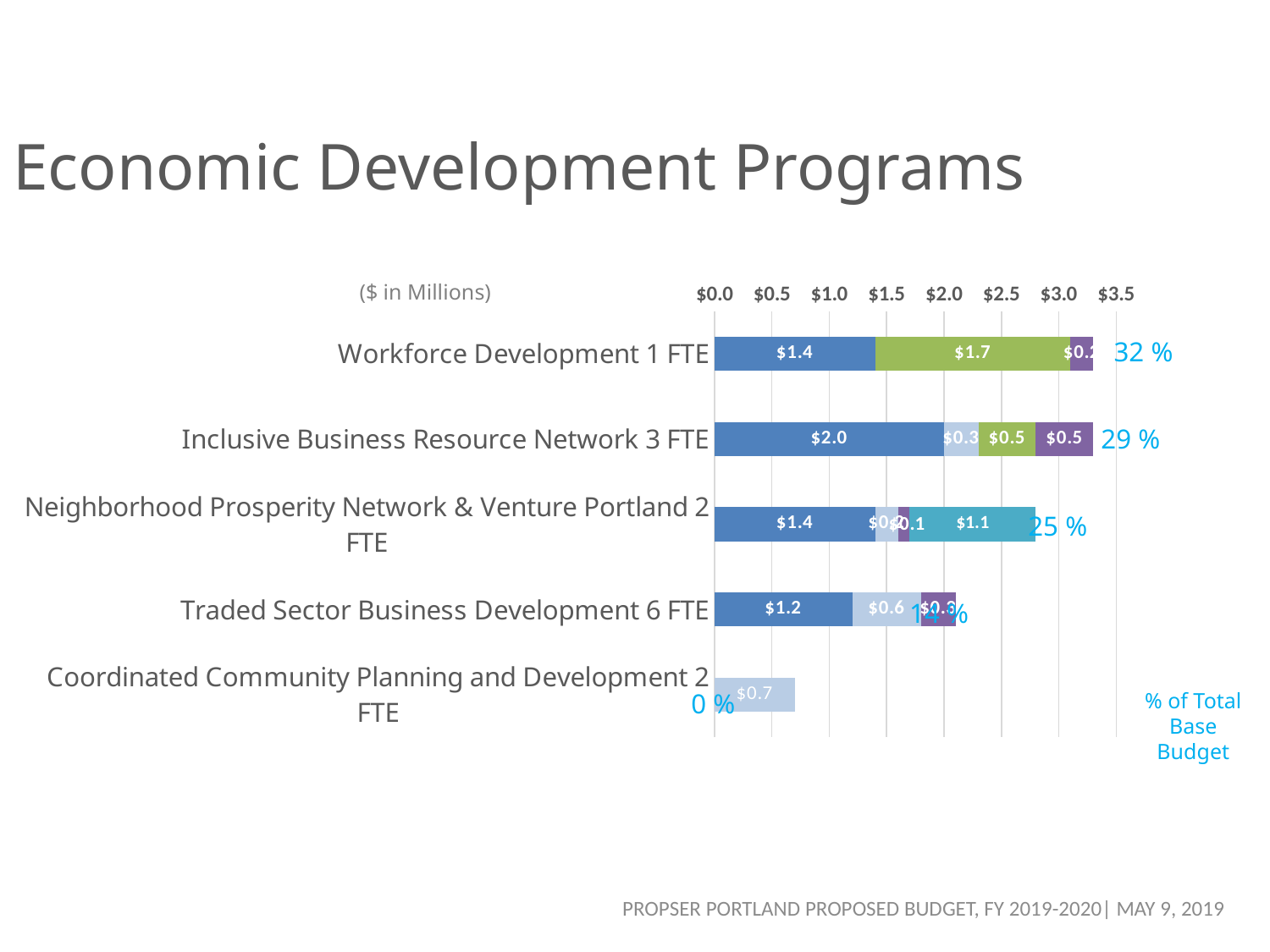
What kind of chart is shown on the slide? Stacked bar chart What is the % of Total Base Budget for Workforce Development 1 FTE? 32 % Which program has the lowest % of Total Base Budget? Coordinated Community Planning and Development 2 FTE What is the % of Total Base Budget for Inclusive Business Resource Network 3 FTE? 29 % What unit label is shown above the category axis of the chart? ($ in Millions) What is the total of the Inclusive Business Resource Network 3 FTE bar? $3.3 What is the value of the first (dark blue) segment of the Inclusive Business Resource Network 3 FTE bar? $2.0 Is the total bar for Coordinated Community Planning and Development 2 FTE greater or less than $1.0? less How many programs are listed on the chart? 5 What is the % of Total Base Budget for Coordinated Community Planning and Development 2 FTE? 0 % Which program has the highest % of Total Base Budget? Workforce Development 1 FTE